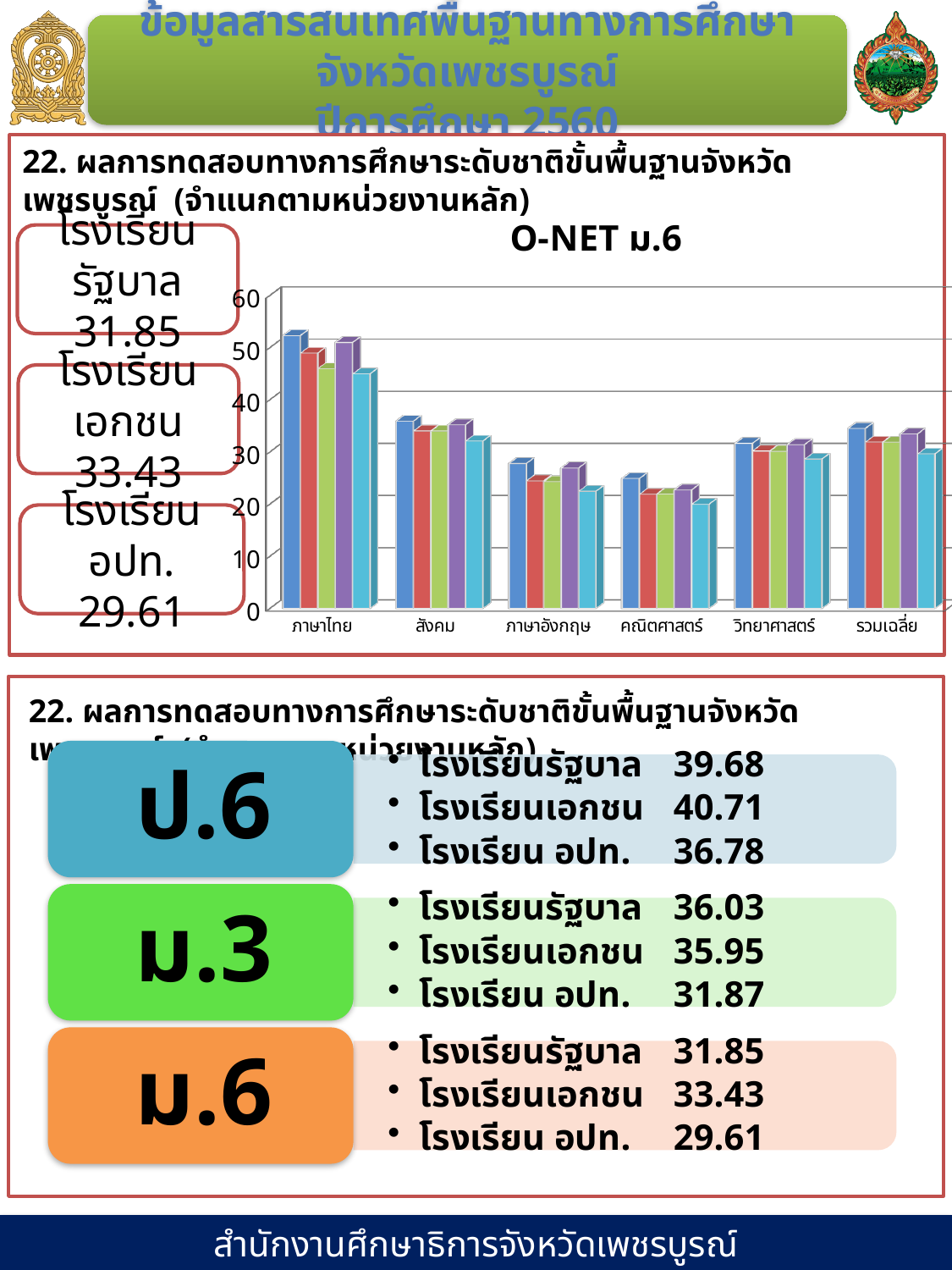
Is the value of the first (blue) bar for สังคม greater or less than 30? greater Is the value of the last (light blue) bar for ภาษาอังกฤษ greater or less than 30? less What is the title of the chart? O-NET ม.6 Is the value of the first (blue) bar for ภาษาไทย greater or less than 40? greater Which has the larger first (blue) bar, วิทยาศาสตร์ or คณิตศาสตร์? วิทยาศาสตร์ How many bars are plotted for each category in the chart? 5 What kind of chart is shown on the slide? bar chart Which has the larger first (blue) bar, ภาษาไทย or สังคม? ภาษาไทย How many subject categories are shown on the x axis of the chart? 6 Which category has the lowest bars in the chart? คณิตศาสตร์ Which category has the highest bars in the chart? ภาษาไทย